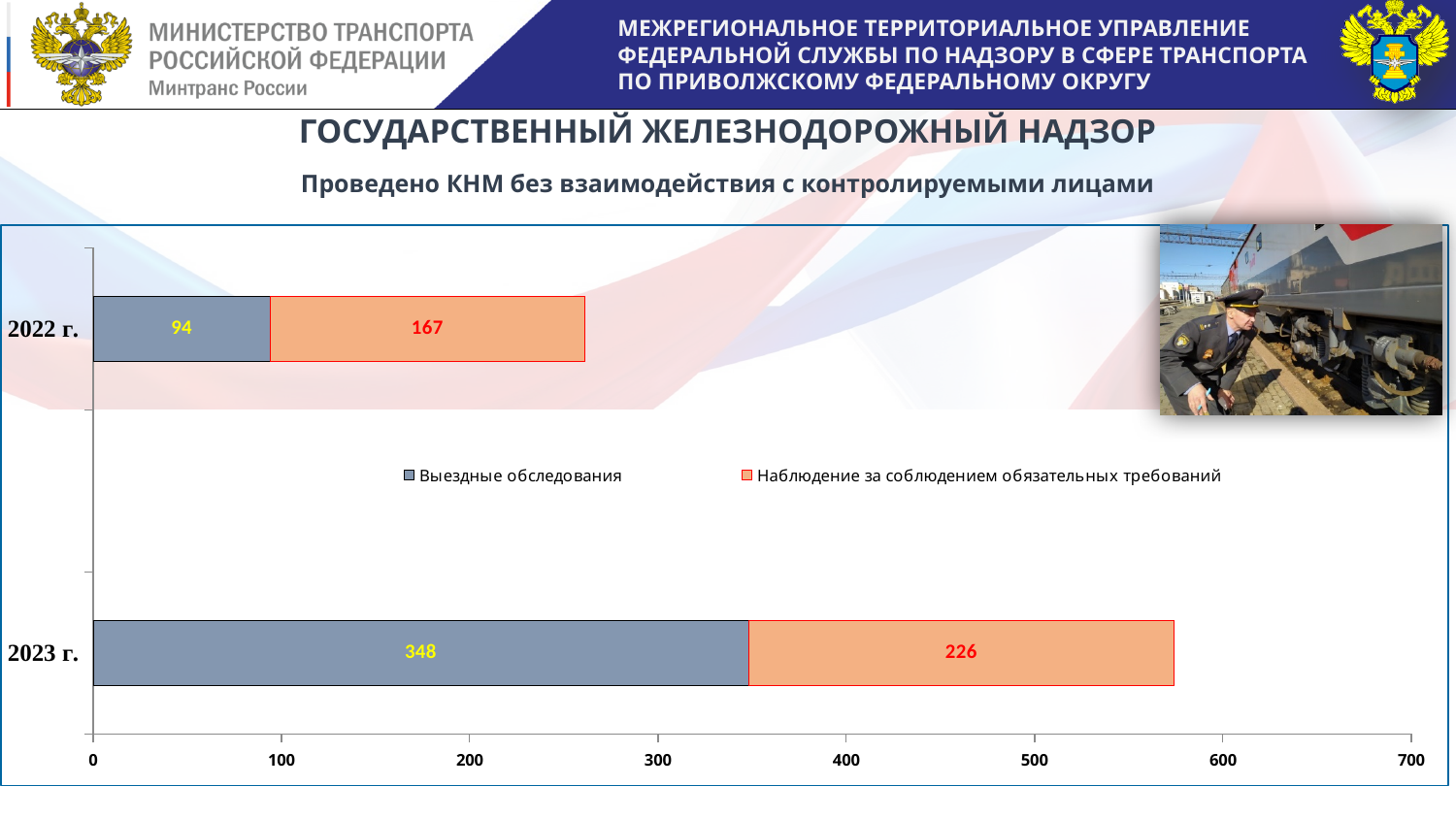
What is the value for Выездные обследования in 2023 г.? 348 Which year has the higher value for Наблюдение за соблюдением обязательных требований? 2023 г. What is the value for Наблюдение за соблюдением обязательных требований in 2022 г.? 167 What is the value for Наблюдение за соблюдением обязательных требований in 2023 г.? 226 What is the total of the stacked bar for 2023 г.? 574 What kind of chart is shown on the slide? Stacked bar chart How many categories are shown on the chart? 2 What is the difference between Выездные обследования in 2023 г. and in 2022 г.? 254 Which is larger in 2023 г.: Выездные обследования or Наблюдение за соблюдением обязательных требований? Выездные обследования How many series does the legend list? 2 What is the value for Выездные обследования in 2022 г.? 94 What is the total of the stacked bar for 2022 г.? 261